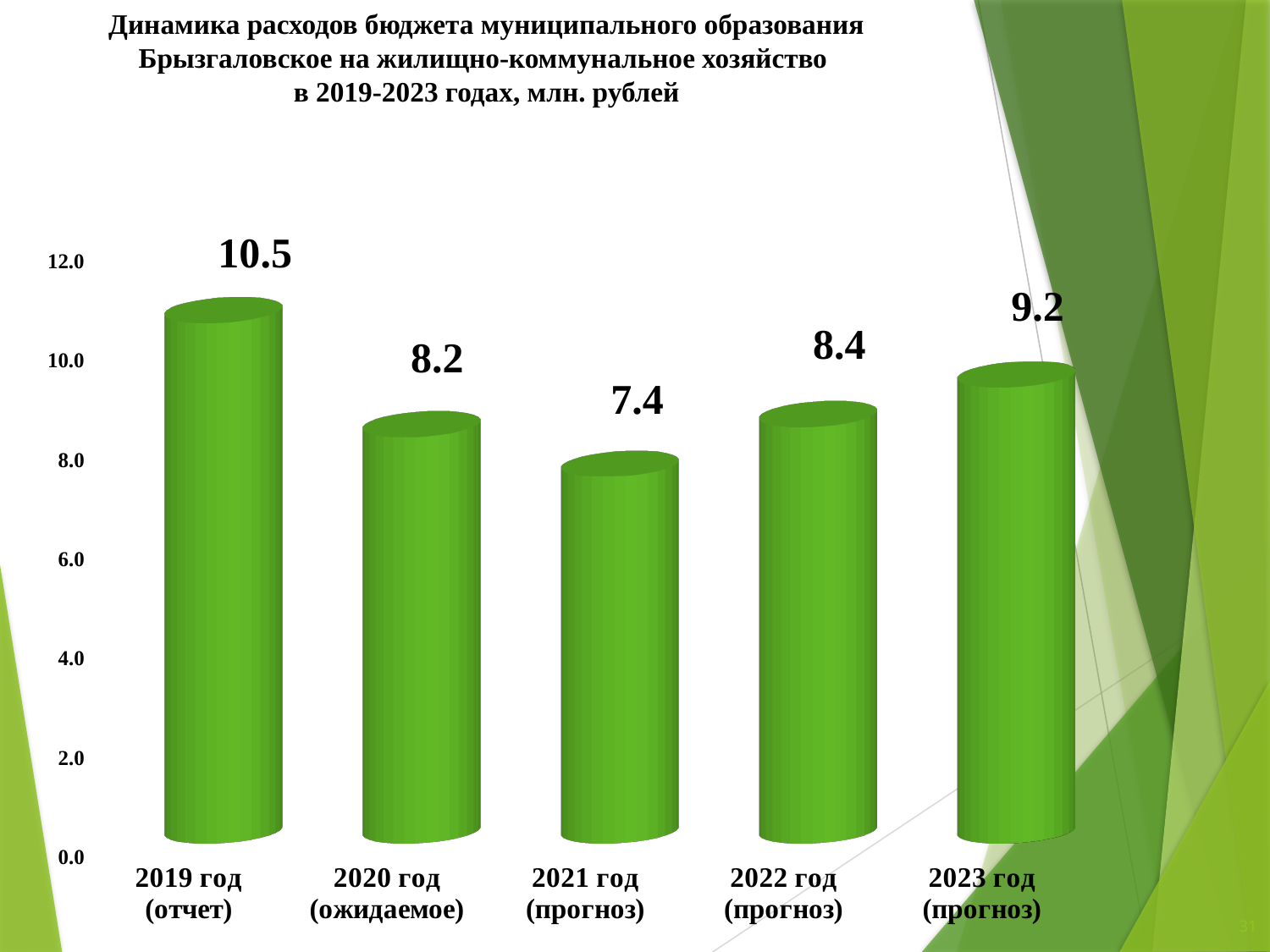
Which year has the highest value? 2019 год (отчет) What is the value for 2023 год (прогноз)? 9.2 What is the difference between the values for 2019 год (отчет) and 2023 год (прогноз)? 1.3 What is the value for 2021 год (прогноз)? 7.4 Which year has the lowest value? 2021 год (прогноз) What is the value for 2019 год (отчет)? 10.5 Which is larger, the value for 2020 год (ожидаемое) or the value for 2022 год (прогноз)? 2022 год (прогноз) Do the values rise or fall from 2021 год (прогноз) to 2023 год (прогноз)? rise What kind of chart is shown on the slide? bar chart How many years are shown on the chart? 5 What is the difference between the values for 2022 год (прогноз) and 2021 год (прогноз)? 1.0 Is the value for 2020 год (ожидаемое) greater or less than 8.0? greater